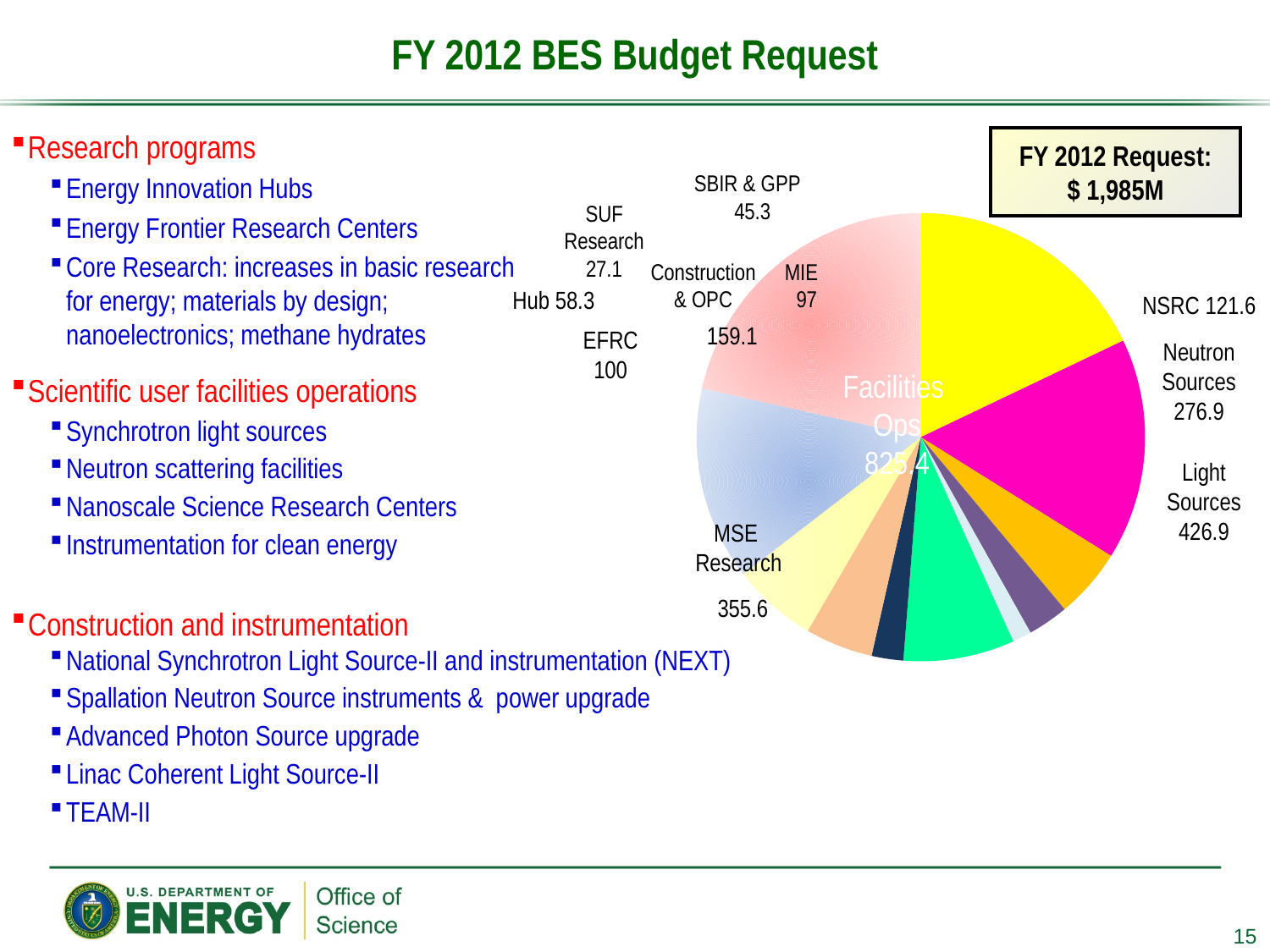
What is the value shown for SBIR & GPP in the pie chart? 45.3 What is the difference between the Light Sources value and the Neutron Sources value in the pie chart? 150.0 What is the value shown for MSE Research in the pie chart? 355.6 What type of chart is shown on the slide? pie chart What is the difference between the EFRC value and the Hub value in the pie chart? 41.7 What is the value shown for EFRC in the pie chart? 100 Which is larger in the pie chart, Light Sources or Neutron Sources? Light Sources What is the value shown for Light Sources in the pie chart? 426.9 What is the value shown for Construction & OPC in the pie chart? 159.1 What is the value shown for NSRC in the pie chart? 121.6 What total FY 2012 request amount is shown in the box next to the pie chart? $ 1,985M What is the value shown for Neutron Sources in the pie chart? 276.9